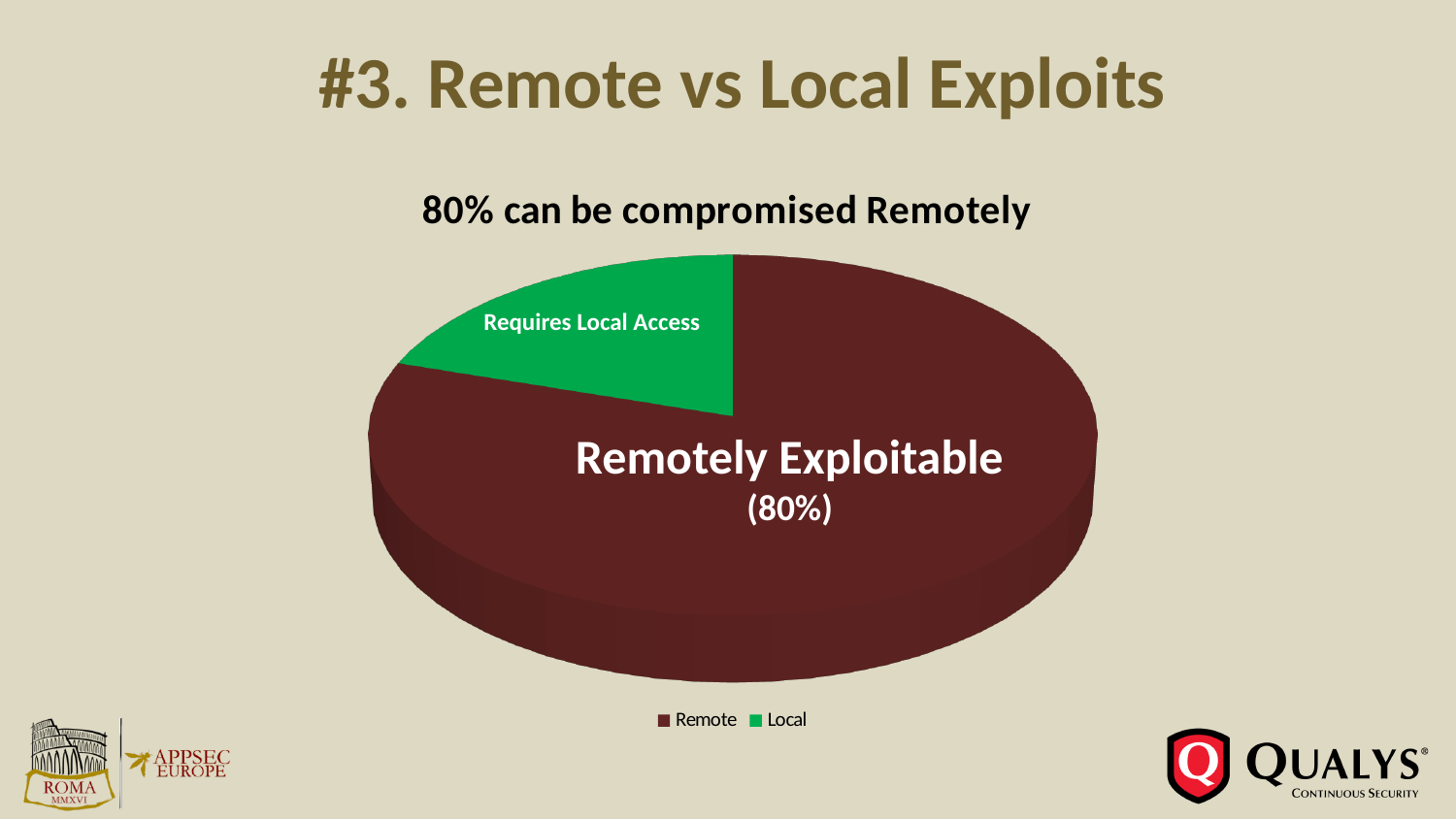
How many entries does the legend of the pie chart list? 2 Which slice of the pie chart is the largest? Remote What colour is the Local slice in the pie chart? Green What is the title shown above the pie chart? 80% can be compromised Remotely What text label is printed on the green slice of the pie chart? Requires Local Access What kind of chart is shown on the slide? Pie chart Which slice of the pie chart is the smallest? Local What percentage is printed on the Remotely Exploitable slice? 80% Which is larger in the pie chart, the Remote slice or the Local slice? Remote How many slices does the pie chart have? 2 What share of the pie is labelled as Remotely Exploitable? 80%